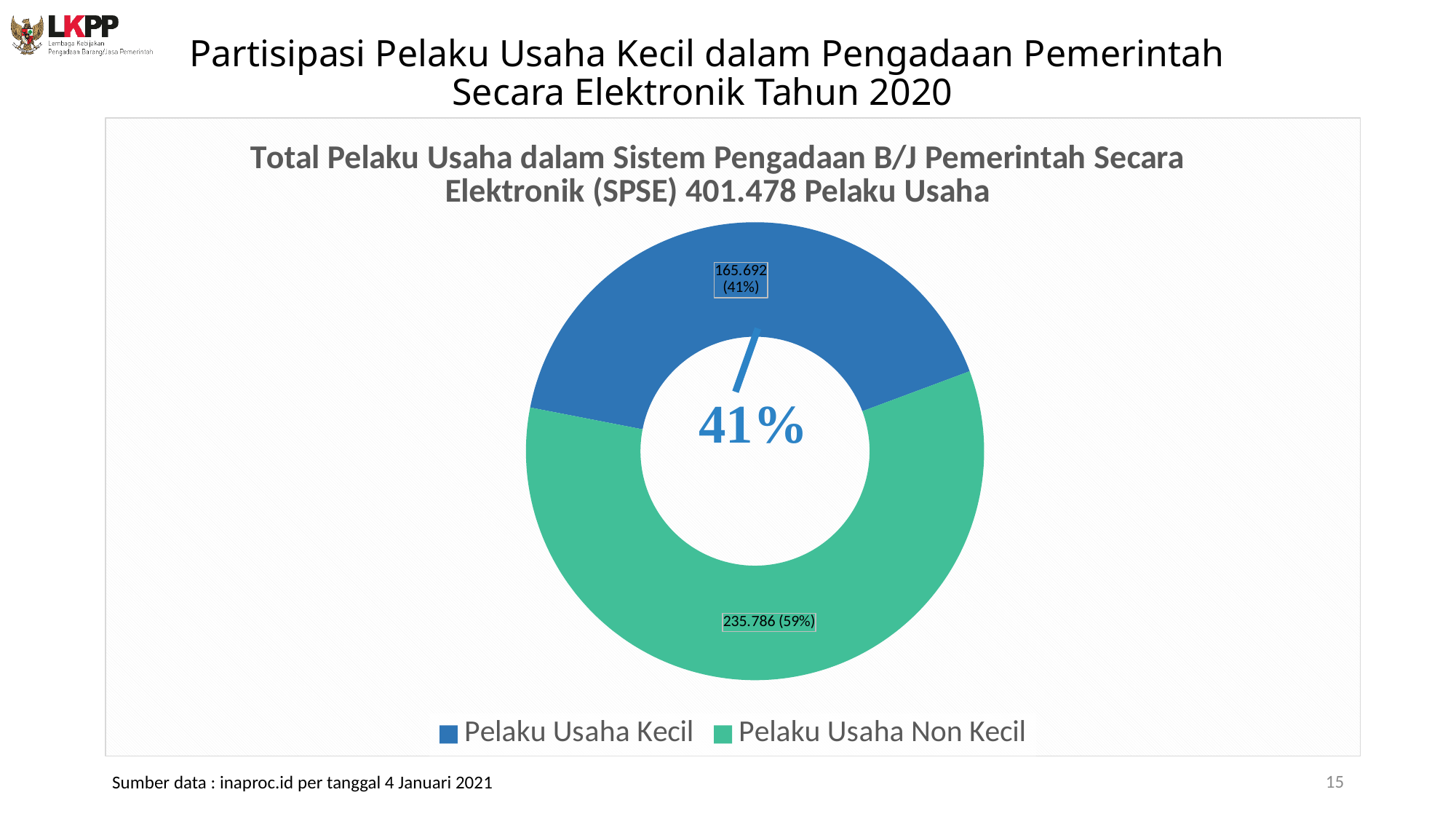
What is the value for Pelaku Usaha Kecil? 165.692 What total number of Pelaku Usaha is stated in the chart title? 401.478 How many categories does the legend list? 2 What is the value for Pelaku Usaha Non Kecil? 235.786 What share of the chart does Pelaku Usaha Non Kecil represent? 59% Which category has the smallest slice? Pelaku Usaha Kecil What colour is the Pelaku Usaha Kecil slice? Blue What is the difference between the values for Pelaku Usaha Non Kecil and Pelaku Usaha Kecil? 70.094 What share of the chart does Pelaku Usaha Kecil represent? 41% Which category has the largest slice? Pelaku Usaha Non Kecil Which is larger, Pelaku Usaha Kecil or Pelaku Usaha Non Kecil? Pelaku Usaha Non Kecil What kind of chart is shown on the slide? Doughnut (pie) chart